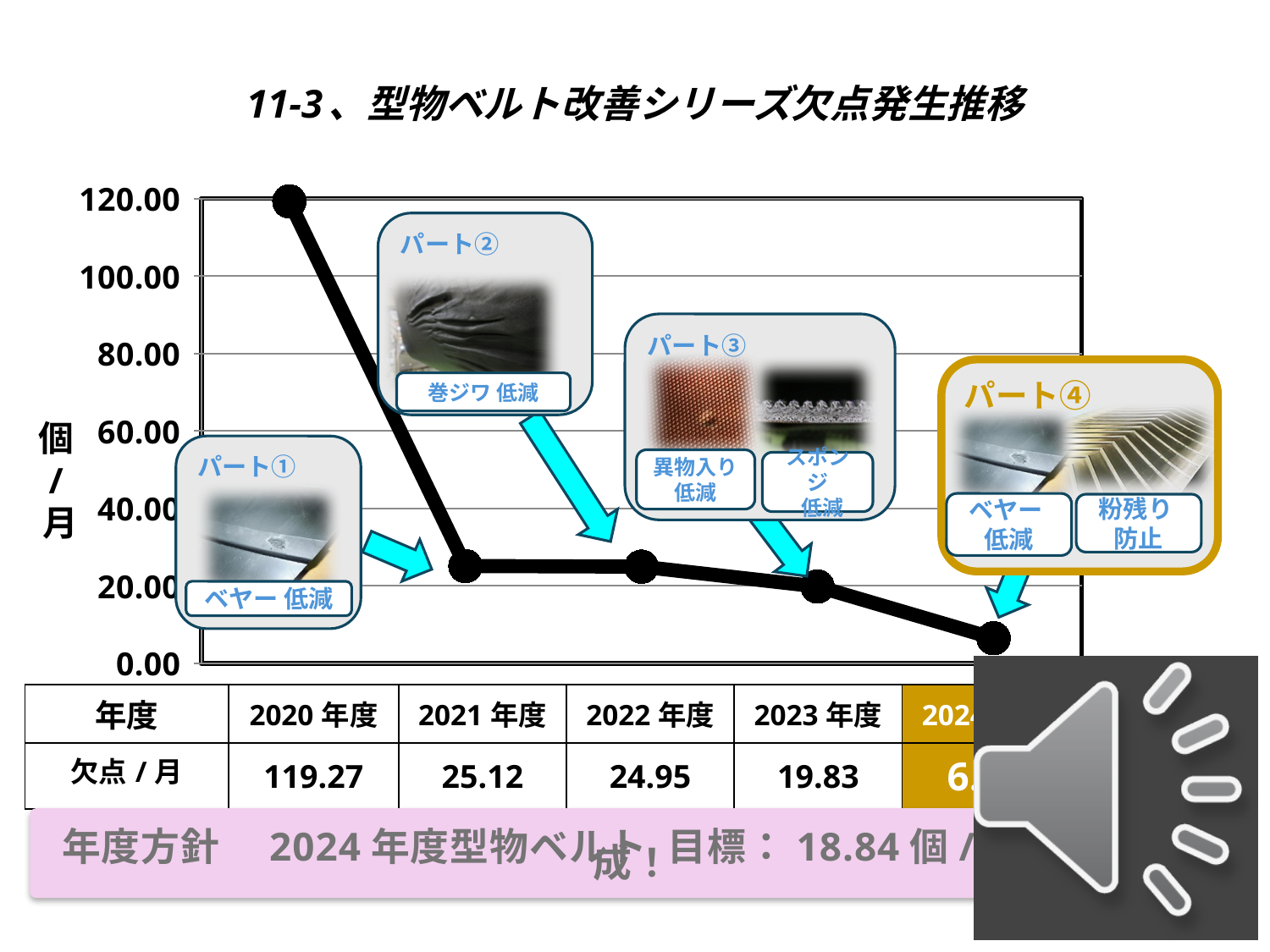
What is the 欠点/月 value for 2020年度? 119.27 What is the 欠点/月 value for 2022年度? 24.95 How many data points are plotted on the line? 5 Do the values rise or fall from 2020年度 to 2024年度? fall What is the 欠点/月 value for 2021年度? 25.12 What is the difference between the 2022年度 and 2023年度 values? 5.12 Which year has the lowest 欠点/月 value? 2024年度 Is the value for 2024年度 greater or less than 20.00? less What type of chart is shown on the slide? line chart What is the difference between the 2020年度 and 2021年度 values? 94.15 Which year has the highest 欠点/月 value? 2020年度 What is the 欠点/月 value for 2023年度? 19.83